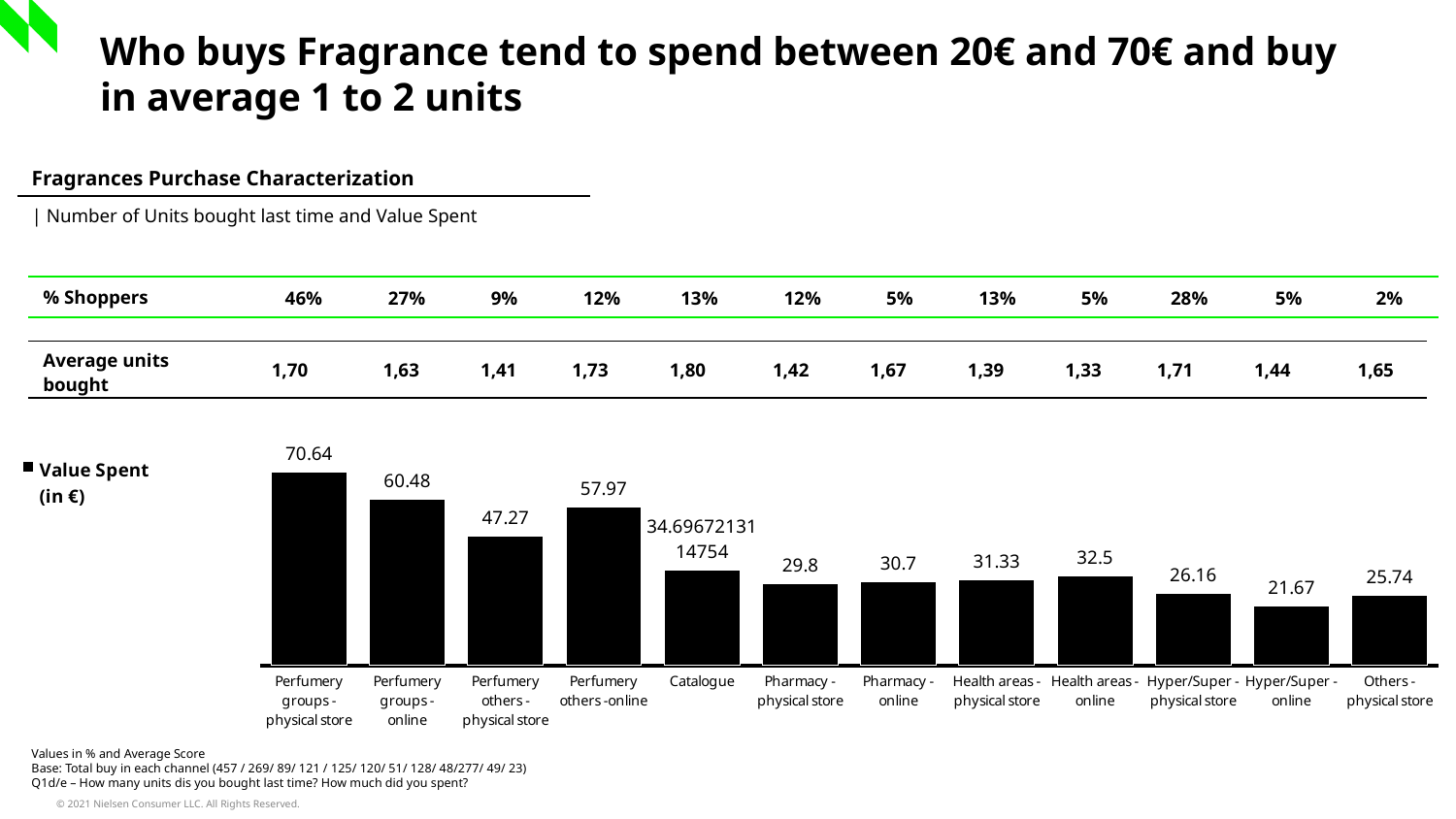
How many channels are shown on the x axis of the chart? 12 What is the difference in Value Spent between Perfumery groups - physical store and Perfumery groups - online? 10.16 How many series does the chart's legend list? 1 What is the Value Spent (in €) for Perfumery others - online? 57.97 What is the difference in Value Spent between Perfumery others - online and Perfumery others - physical store? 10.7 Which has a higher Value Spent, Pharmacy - physical store or Hyper/Super - physical store? Pharmacy - physical store What is the Value Spent (in €) for Hyper/Super - online? 21.67 Which channel has the lowest Value Spent? Hyper/Super - online Which channel has the highest Value Spent? Perfumery groups - physical store What kind of chart is used to show Value Spent? Bar chart What is the Value Spent (in €) for Health areas - online? 32.5 What is the Value Spent (in €) for Perfumery groups - physical store? 70.64